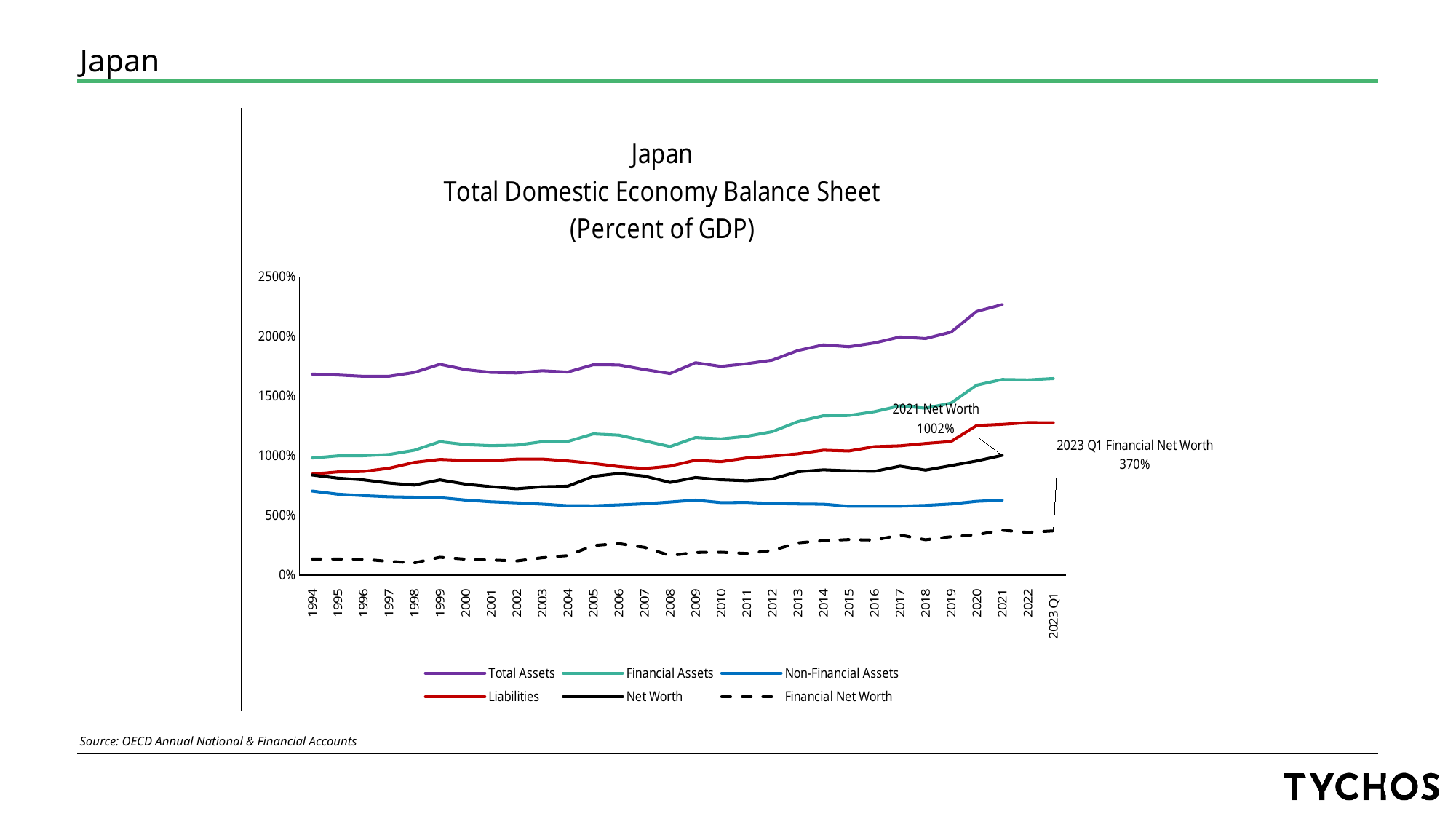
Which series has the lowest values across the chart? Financial Net Worth Is the value for Non-Financial Assets in 2021 greater or less than 1000%? less What kind of chart is shown on the slide? line chart What is the Net Worth value labelled for 2021? 1002% Is the value for Total Assets in 2021 greater or less than 2000%? greater Which series has the highest values across the chart? Total Assets Which series is drawn as a dashed line? Financial Net Worth In 2021, which is larger: Financial Assets or Liabilities? Financial Assets What is the Financial Net Worth value labelled for 2023 Q1? 370% Is the value for Financial Assets in 2021 greater or less than 1500%? greater How many series does the legend list? 6 Do Total Assets rise or fall from 1994 to 2021? rise